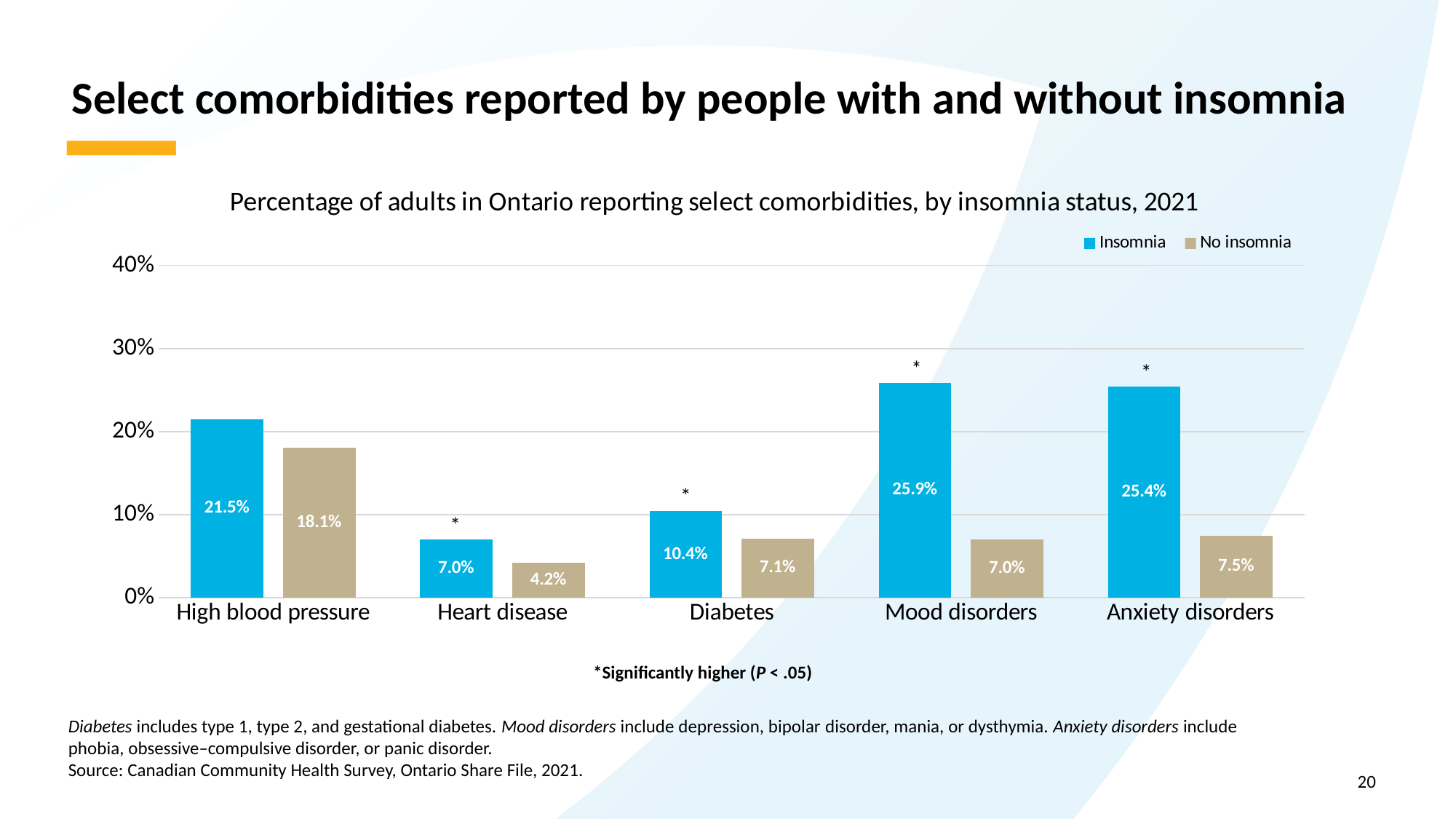
What percentage of adults without insomnia reported heart disease? 4.2% Which is larger: the Insomnia value for Diabetes or the Insomnia value for Heart disease? Diabetes Which comorbidity has the lowest value in the No insomnia series? Heart disease What is the difference between the Insomnia and No insomnia values for Mood disorders? 18.9% What is the value for Diabetes in the No insomnia series? 7.1% What percentage of adults with insomnia reported high blood pressure? 21.5% Is the Insomnia value for Anxiety disorders greater or less than 20%? greater What kind of chart is shown on the slide? Bar chart How many comorbidity categories are shown on the x axis? 5 Which comorbidity has the highest value in the Insomnia series? Mood disorders Which colour represents the Insomnia series? Blue How many series does the legend list? 2